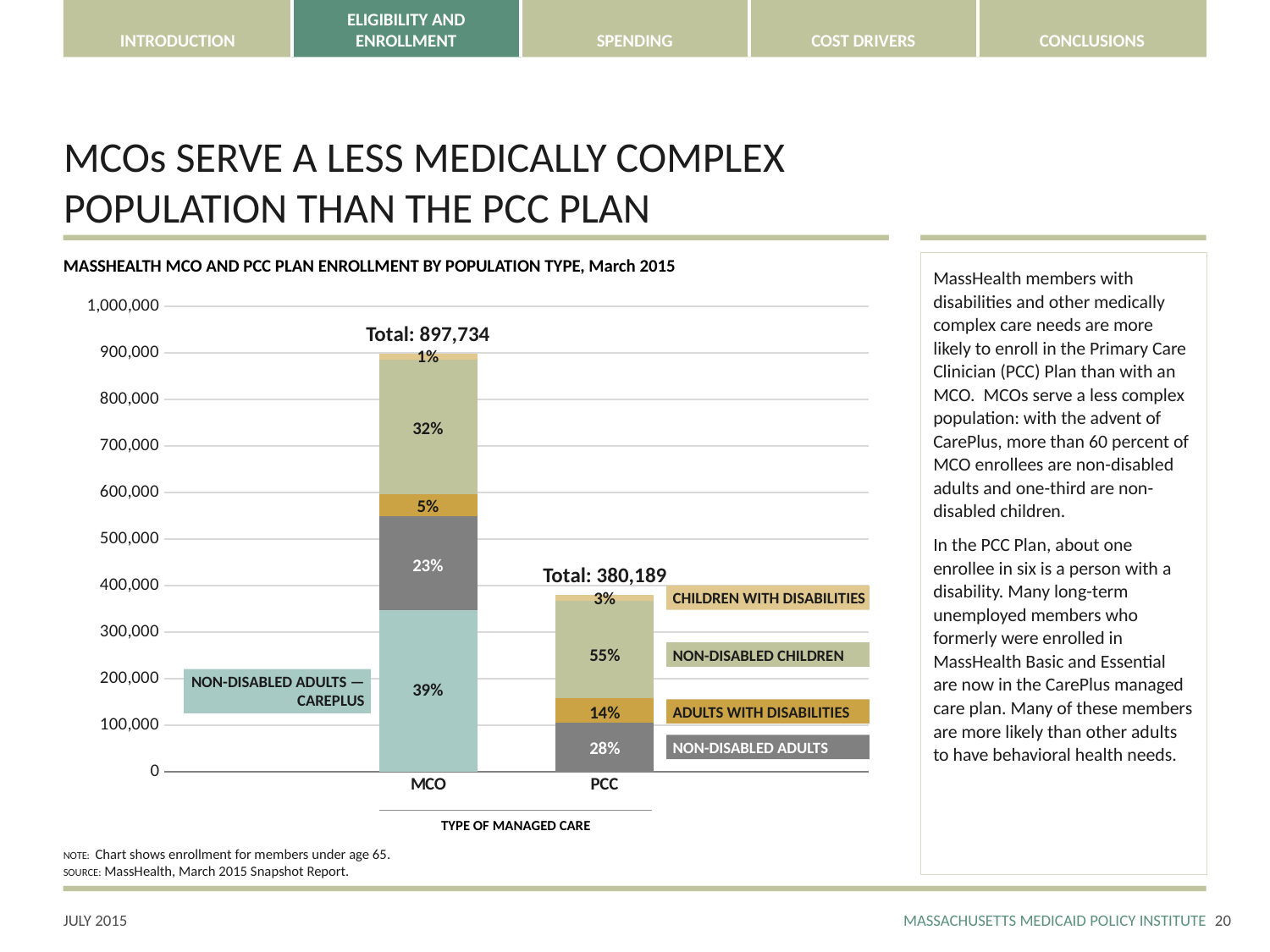
What kind of chart is shown on the slide? Stacked bar chart What is the total enrollment shown for the PCC bar? 380,189 What percentage of PCC Plan enrollment is children with disabilities? 3% What is the title of the x axis? TYPE OF MANAGED CARE Is the total enrollment for PCC greater or less than 400,000? less How many types of managed care are shown on the x axis? 2 What is the difference between the MCO total and the PCC total enrollment? 517,545 What percentage of MCO enrollment is adults with disabilities? 5% What is the total enrollment shown for the MCO bar? 897,734 What percentage of PCC Plan enrollment is non-disabled children? 55% What percentage of MCO enrollment is non-disabled adults in CarePlus? 39% Which type of managed care has the higher total enrollment, MCO or PCC? MCO